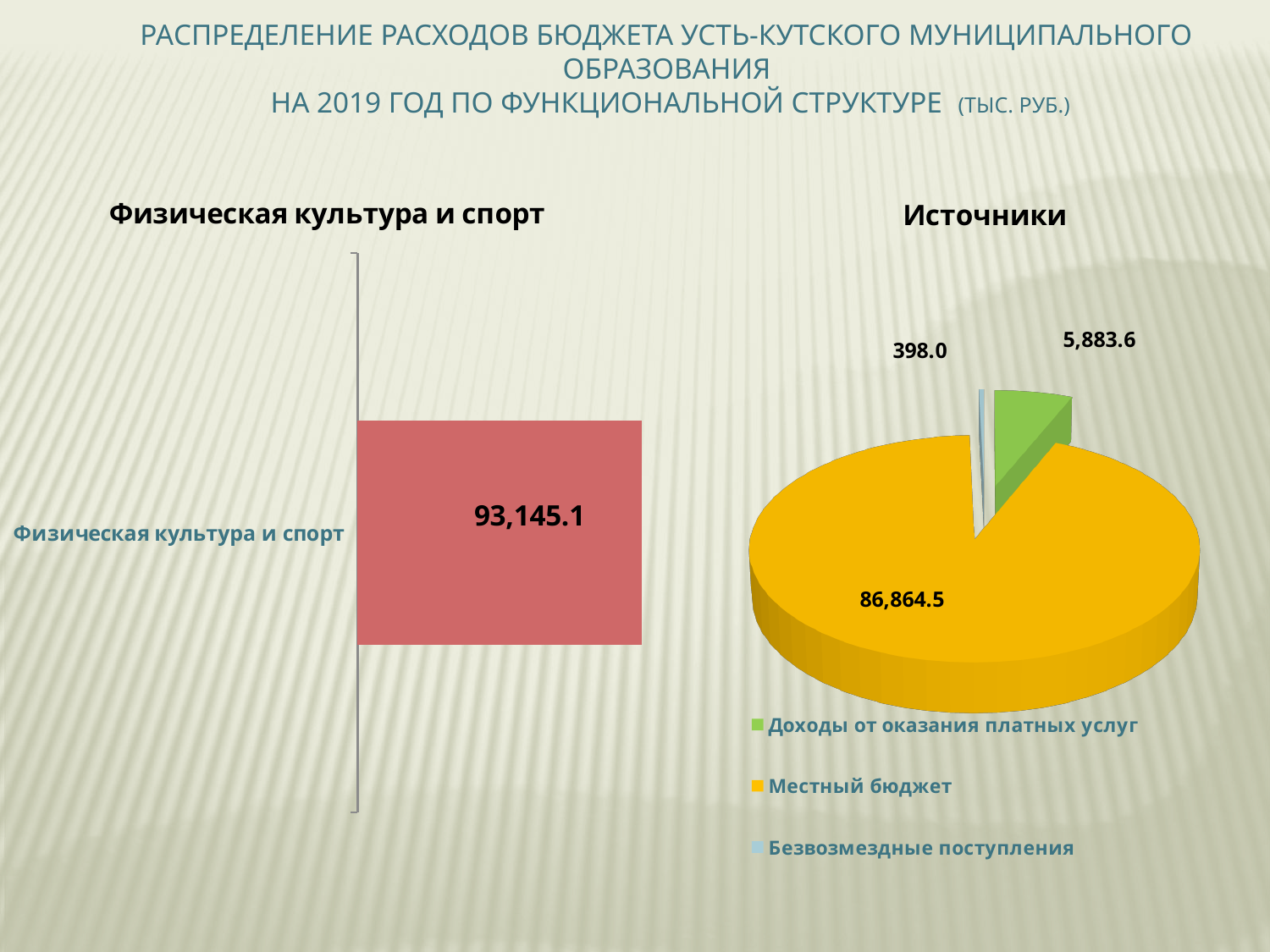
What kind of chart is the 'Источники' chart? pie chart On the 'Источники' chart, which source has the largest value? Местный бюджет On the 'Источники' chart, what colour is the 'Местный бюджет' slice? yellow How many entries does the legend of the 'Источники' chart list? 3 What kind of chart is the 'Физическая культура и спорт' chart? bar chart On the 'Источники' chart, which source has the smallest value? Безвозмездные поступления On the 'Источники' chart, what is the value for 'Местный бюджет'? 86,864.5 On the 'Источники' chart, what is the difference between 'Местный бюджет' and 'Доходы от оказания платных услуг'? 80,980.9 How many bars are plotted on the 'Физическая культура и спорт' chart? 1 On the 'Источники' chart, what is the value for 'Безвозмездные поступления'? 398.0 On the 'Источники' chart, what is the value for 'Доходы от оказания платных услуг'? 5,883.6 On the 'Физическая культура и спорт' chart, what is the value of the bar? 93,145.1